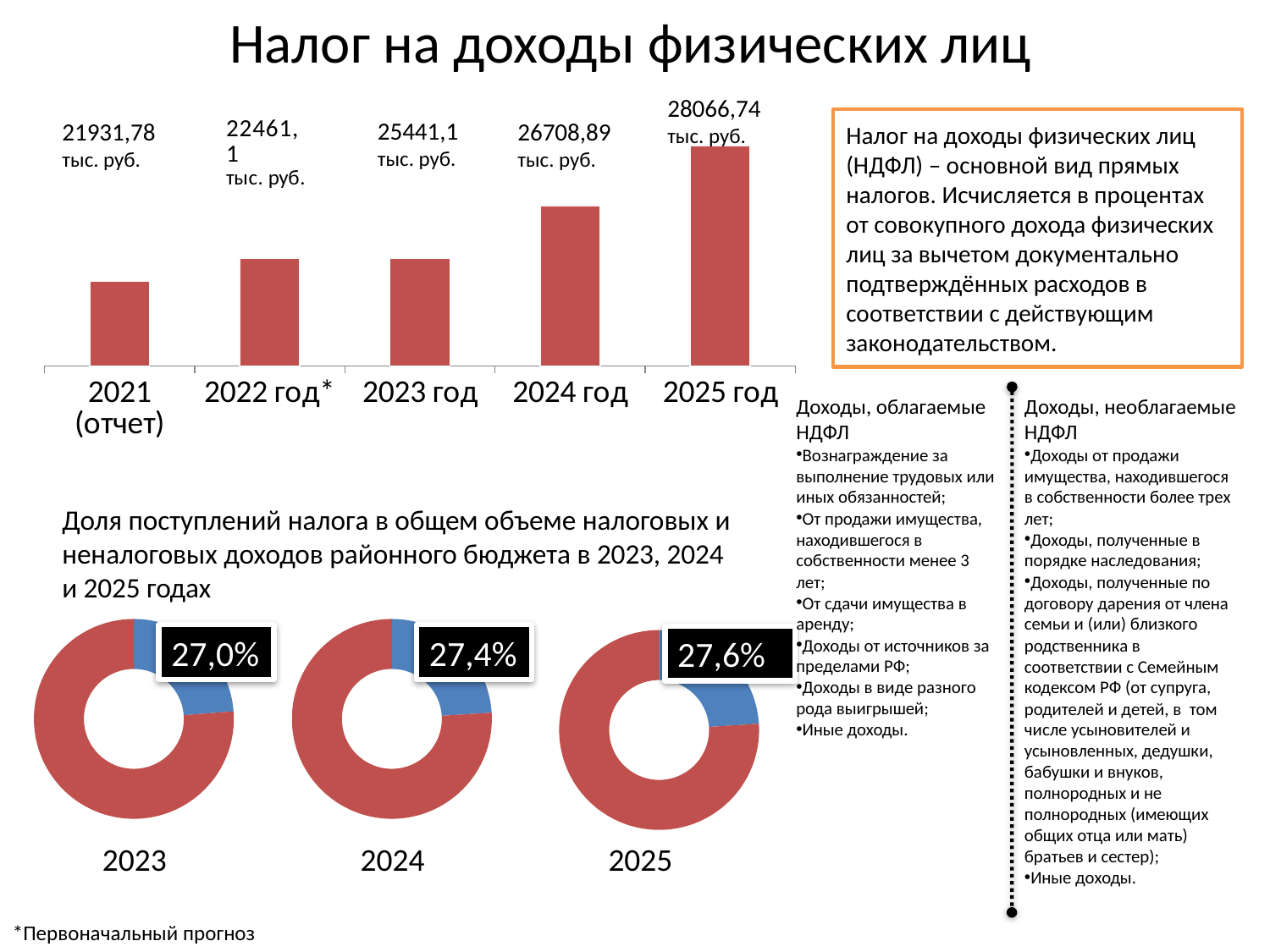
In the donut chart for 2024 at the bottom of the slide, what share is shown by the data label? 27,4% In the bar chart at the top of the slide, what is the value for 2021 (отчет)? 21931,78 тыс. руб. In the bar chart at the top of the slide, which year has the highest value? 2025 год In the bar chart at the top of the slide, which year has the lowest value? 2021 (отчет) In the bar chart at the top of the slide, do the values rise or fall from 2021 to 2025? rise In the bar chart at the top of the slide, what is the difference between the values for 2025 год and 2021 (отчет)? 6134,96 тыс. руб. In the bar chart at the top of the slide, what is the value for 2023 год? 25441,1 тыс. руб. In the bar chart at the top of the slide, which is larger: the value for 2022 год* or the value for 2024 год? 2024 год What type of chart is used at the top of the slide to show the tax revenue by year? bar chart In the bar chart at the top of the slide, what is the difference between the values for 2024 год and 2023 год? 1267,79 тыс. руб. In the bar chart at the top of the slide, what is the value for 2025 год? 28066,74 тыс. руб. How many bars are in the bar chart at the top of the slide? 5